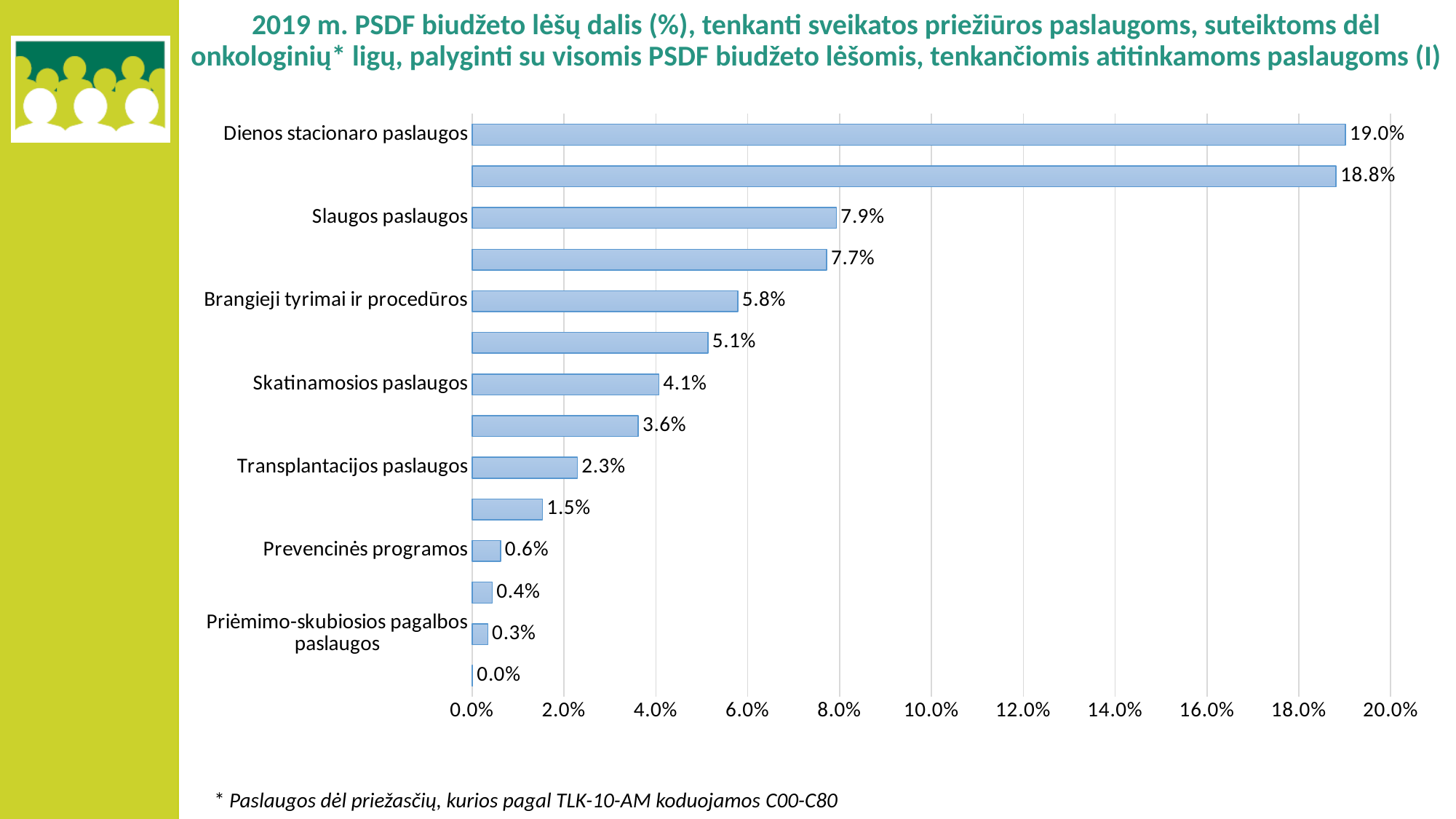
Is the value for Slaugos paslaugos greater or less than 8.0%? less What is the lowest value shown on the chart? 0.0% What kind of chart is shown on the slide? bar chart Which is larger, the value for Skatinamosios paslaugos or the value for Prevencinės programos? Skatinamosios paslaugos What is the value for Priėmimo-skubiosios pagalbos paslaugos? 0.3% Which labelled category has the highest value? Dienos stacionaro paslaugos How many bars are plotted on the chart? 14 What is the value for Dienos stacionaro paslaugos? 19.0% What is the difference between the values for Dienos stacionaro paslaugos and Slaugos paslaugos? 11.1 percentage points What is the value for Slaugos paslaugos? 7.9% What is the value for Brangieji tyrimai ir procedūros? 5.8% What is the value for Transplantacijos paslaugos? 2.3%